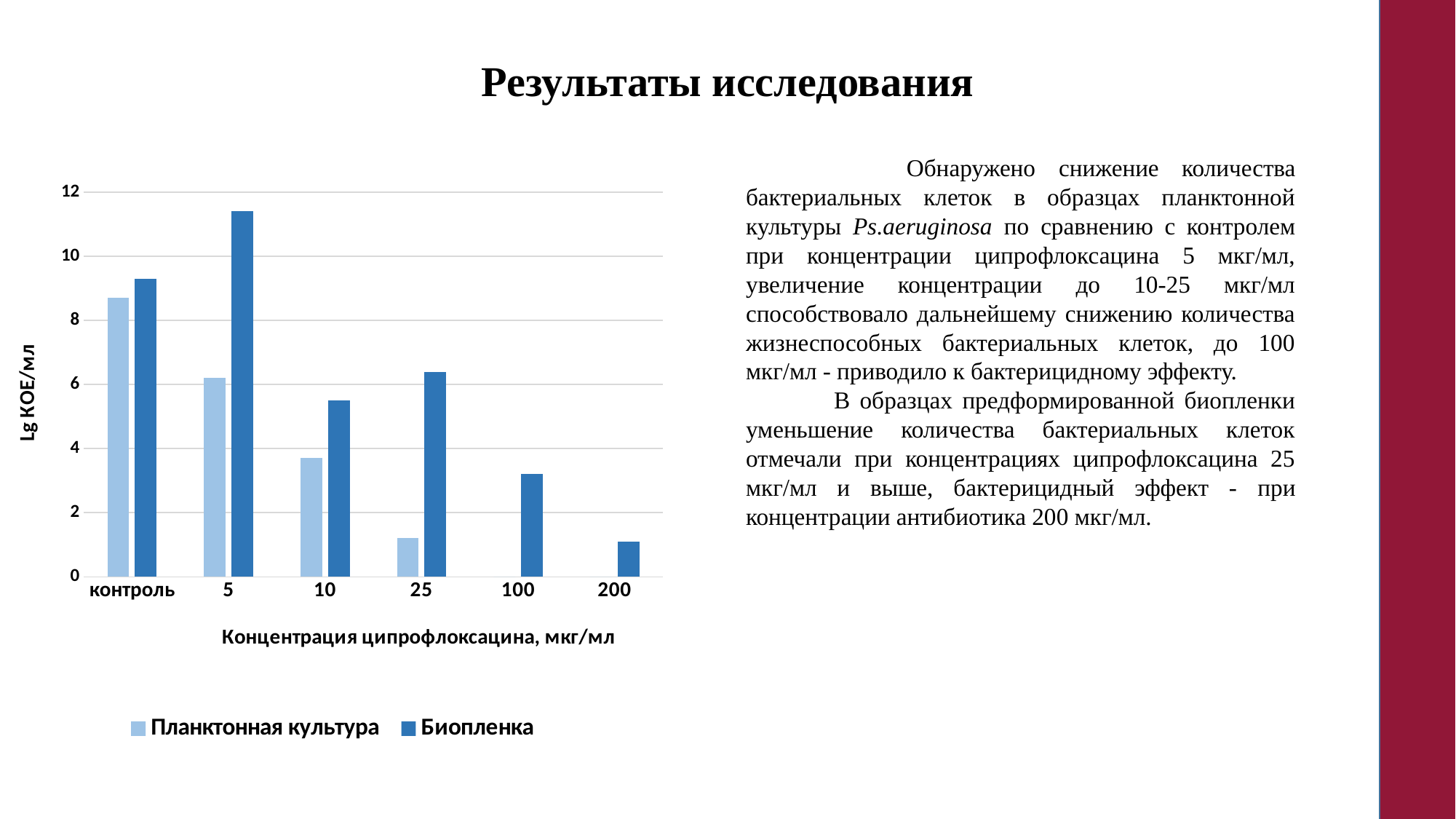
For which category is the Биопленка value highest? 5 What kind of chart is shown on the slide? bar chart Do the Планктонная культура values rise or fall as the concentration increases along the x axis? fall For which category is the Планктонная культура value highest? контроль Is the Биопленка value at concentration 5 greater or less than 10? greater For which category is the Биопленка value lowest? 200 Is the Биопленка value at concentration 100 greater or less than 4? less How many series does the legend list? 2 At concentration 10, which series has the larger value, Планктонная культура or Биопленка? Биопленка Is the Планктонная культура value for контроль greater or less than 8? greater How many concentration categories are shown on the x axis? 6 What is the label of the y axis? Lg КОЕ/мл